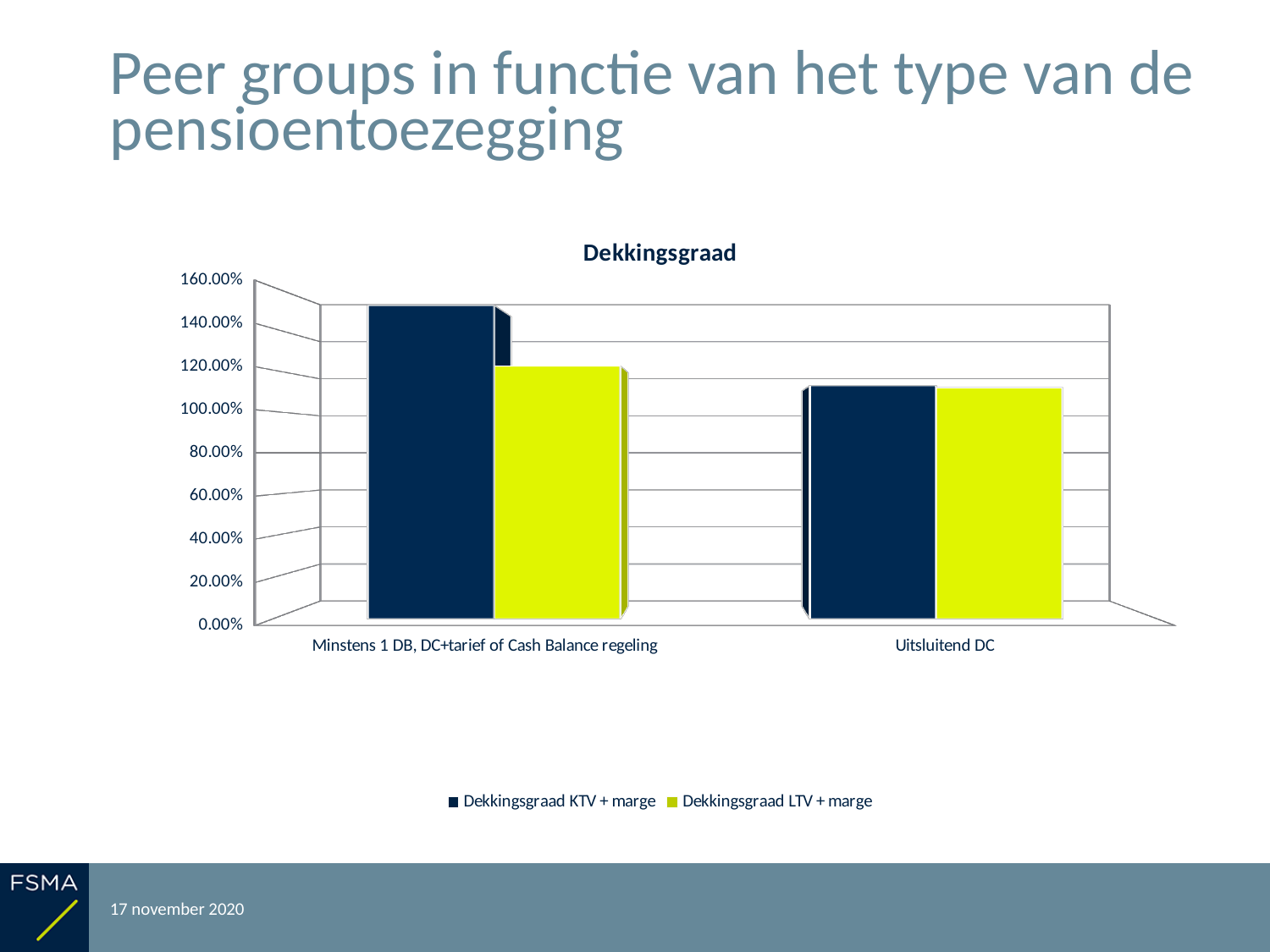
Is the value for Dekkingsgraad KTV + marge in the category 'Minstens 1 DB, DC+tarief of Cash Balance regeling' greater or less than 140.00%? greater Which category has the highest value for Dekkingsgraad KTV + marge? Minstens 1 DB, DC+tarief of Cash Balance regeling How many series does the legend list? 2 What type of chart is shown on the slide? bar chart What is the title of the chart? Dekkingsgraad Is the value for Dekkingsgraad KTV + marge in the category 'Uitsluitend DC' greater or less than 120.00%? less In the category 'Minstens 1 DB, DC+tarief of Cash Balance regeling', which is larger: Dekkingsgraad KTV + marge or Dekkingsgraad LTV + marge? Dekkingsgraad KTV + marge How many categories are shown on the x axis? 2 Which category has the lowest value for Dekkingsgraad LTV + marge? Uitsluitend DC Is the value for Dekkingsgraad LTV + marge in the category 'Uitsluitend DC' greater or less than 100.00%? greater Which series is shown in yellow-green in the legend? Dekkingsgraad LTV + marge Do the values for Dekkingsgraad KTV + marge rise or fall from the first category to the second category? fall